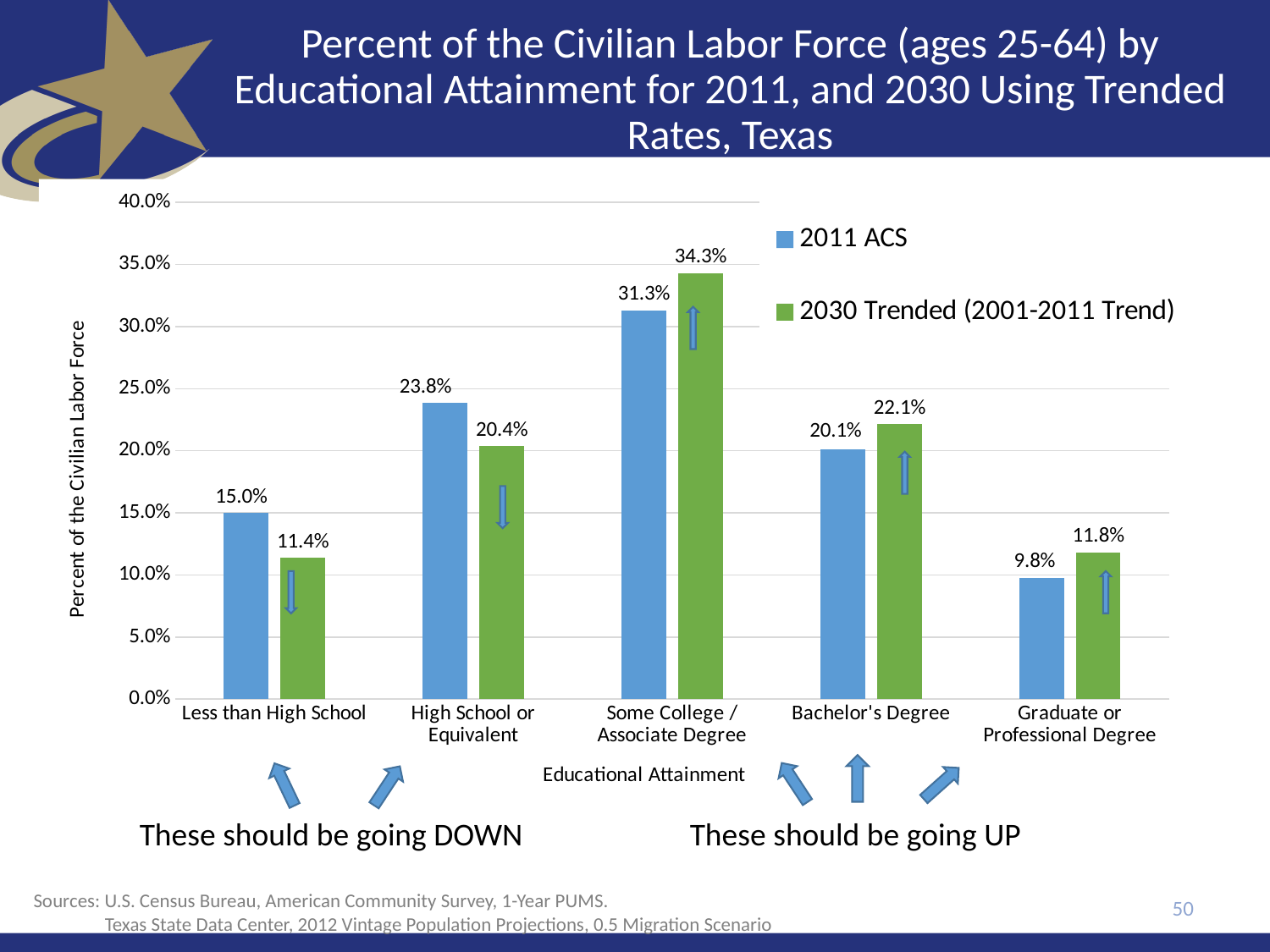
What is the difference between the 2030 Trended and 2011 ACS values for High School or Equivalent? 3.4% Which is larger for Bachelor's Degree: the 2011 ACS value or the 2030 Trended value? 2030 Trended What is the label of the y axis? Percent of the Civilian Labor Force How many educational attainment categories are shown on the x axis? 5 Is the 2011 ACS value for High School or Equivalent greater or less than 25.0%? less Which educational attainment category has the highest 2030 Trended value? Some College / Associate Degree What kind of chart is shown on the slide? bar chart Which educational attainment category has the lowest 2011 ACS value? Graduate or Professional Degree What is the 2030 Trended value for Less than High School? 11.4% How many series does the legend list? 2 What is the 2011 ACS value for Some College / Associate Degree? 31.3% What is the 2030 Trended value for Graduate or Professional Degree? 11.8%